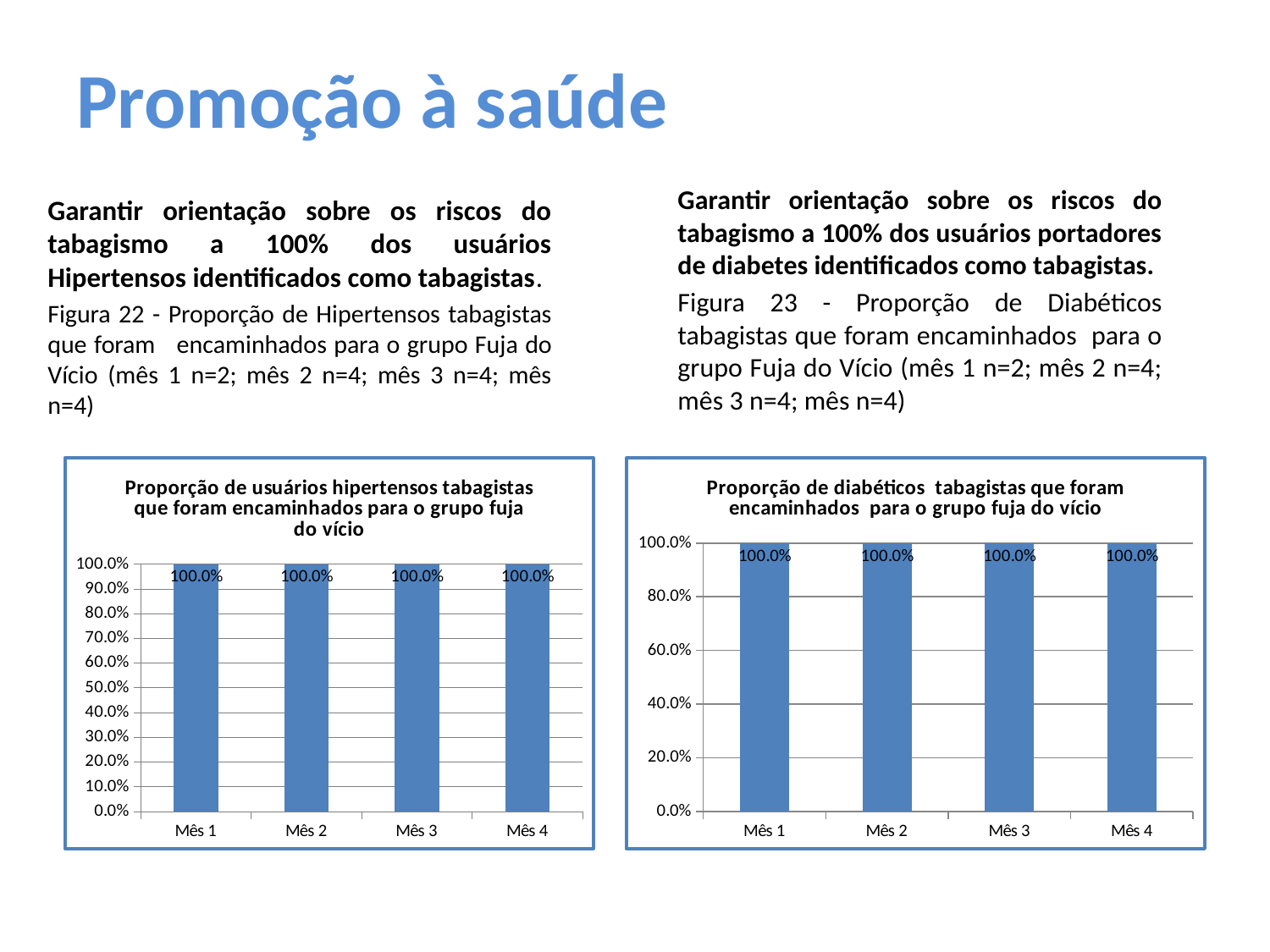
How many bars are plotted in the right chart (Proporção de diabéticos tabagistas)? 4 What is the title of the right chart? Proporção de diabéticos tabagistas que foram encaminhados para o grupo fuja do vício How many categories are shown on the x axis of the left chart (Proporção de usuários hipertensos tabagistas)? 4 In the right chart (Proporção de diabéticos tabagistas), what is the value for Mês 3? 100.0% What kind of chart is the left chart (Proporção de usuários hipertensos tabagistas)? Bar chart What is the highest tick label on the y axis of the left chart (Proporção de usuários hipertensos tabagistas)? 100.0% In the left chart (Proporção de usuários hipertensos tabagistas), what is the value for Mês 4? 100.0% In the left chart (Proporção de usuários hipertensos tabagistas), what is the value for Mês 1? 100.0% In the right chart (Proporção de diabéticos tabagistas), what is the value for Mês 2? 100.0% In the right chart (Proporção de diabéticos tabagistas), do the values rise, fall or stay the same from Mês 1 to Mês 4? Stay the same In the right chart (Proporção de diabéticos tabagistas), is the value for Mês 1 greater or less than 80.0%? greater In the left chart (Proporção de usuários hipertensos tabagistas), what is the difference between the values for Mês 2 and Mês 3? 0.0%